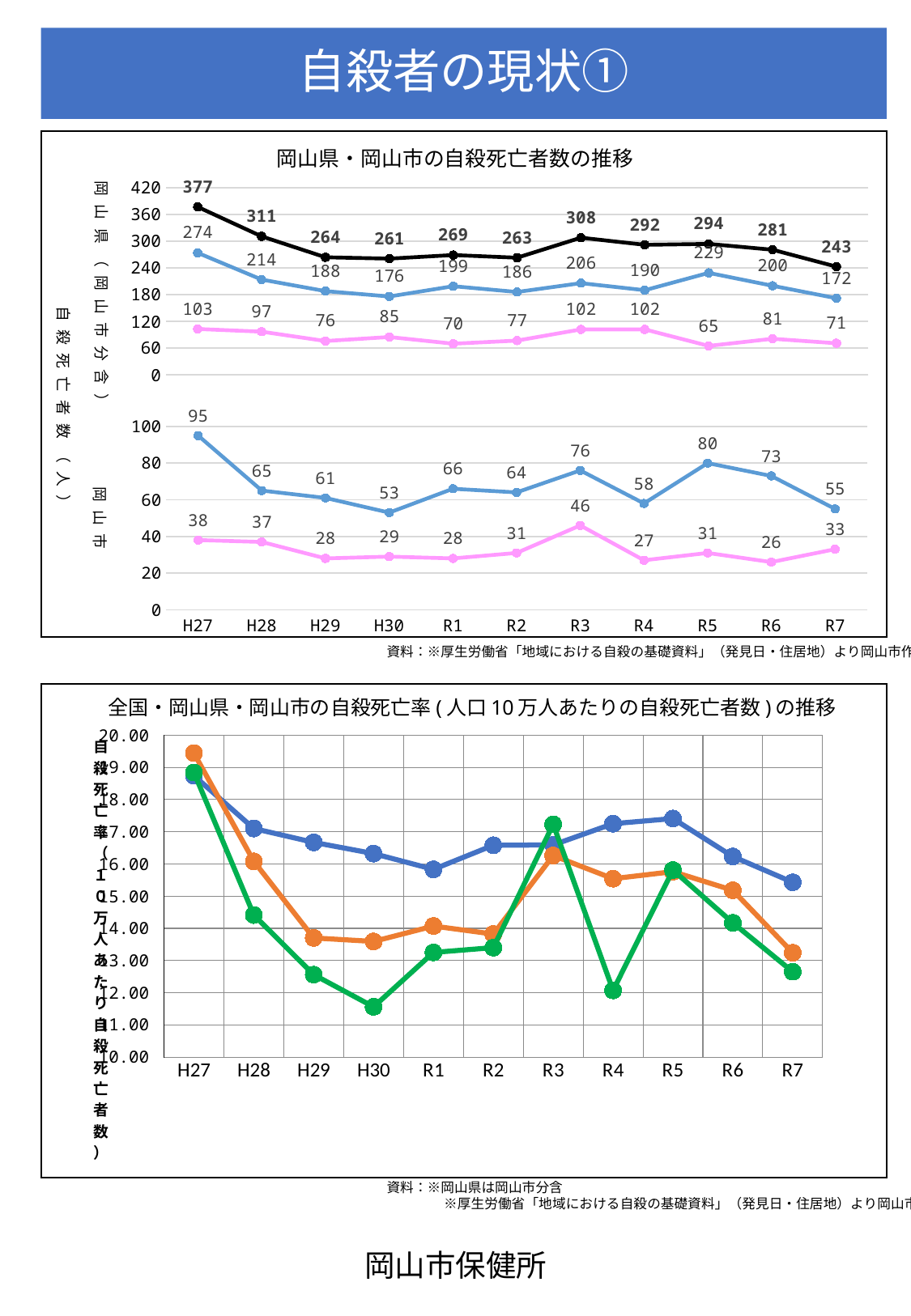
In the top chart '岡山県・岡山市の自殺死亡者数の推移', what is the value of the blue line in the lower 岡山市 panel at R5? 80 In the top chart '岡山県・岡山市の自殺死亡者数の推移', how many years are shown on the x axis? 11 What kind of chart is the bottom chart '全国・岡山県・岡山市の自殺死亡率の推移'? line chart In the top chart '岡山県・岡山市の自殺死亡者数の推移', in the lower 岡山市 panel, which is larger: the blue line value at H27 or at R5? H27 In the bottom chart '全国・岡山県・岡山市の自殺死亡率の推移', is the value of the blue line at R5 greater or less than 17.00? greater In the top chart '岡山県・岡山市の自殺死亡者数の推移', what is the value of the black line at R7? 243 In the top chart '岡山県・岡山市の自殺死亡者数の推移', in which year does the black line reach its highest value? H27 In the top chart '岡山県・岡山市の自殺死亡者数の推移', what is the value of the pink line in the lower 岡山市 panel at R3? 46 In the top chart '岡山県・岡山市の自殺死亡者数の推移', what is the value of the black line at H27? 377 In the top chart '岡山県・岡山市の自殺死亡者数の推移', in which year does the black line reach its lowest value? R7 In the top chart '岡山県・岡山市の自殺死亡者数の推移', what is the difference between the black line values at H27 and H28? 66 In the bottom chart '全国・岡山県・岡山市の自殺死亡率の推移', is the value of the green line at H30 greater or less than 12.00? less